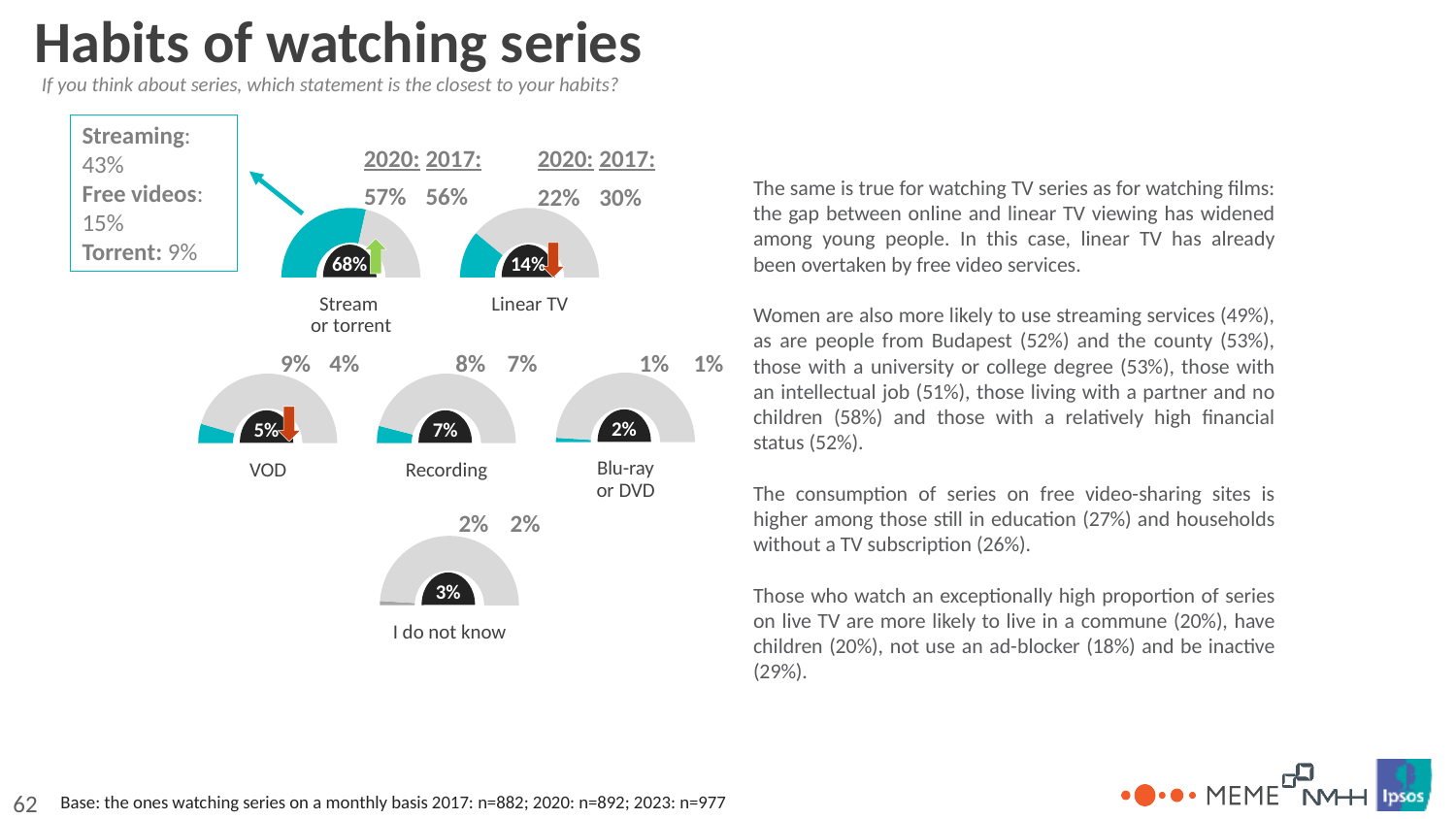
According to the callout box, what share is 'Streaming'? 43% What is the difference between the 2020 and 2017 values for 'Stream or torrent'? 1 percentage point What was the 2017 value for 'Linear TV'? 30% Which category has the highest value shown inside its gauge? Stream or torrent What was the 2020 value for 'Linear TV'? 22% By how many percentage points did 'Linear TV' fall from 2017 to 2020? 8 percentage points What is the value shown inside the 'Stream or torrent' gauge? 68% How many gauge charts are shown on the slide? 6 Which category has the lowest value shown inside its gauge? Blu-ray or DVD Which has the larger value inside its gauge, 'VOD' or 'Recording'? Recording What is the value shown inside the 'I do not know' gauge? 3% Does the value for 'Linear TV' rise or fall from 2017 through 2020 to the value inside the gauge? fall